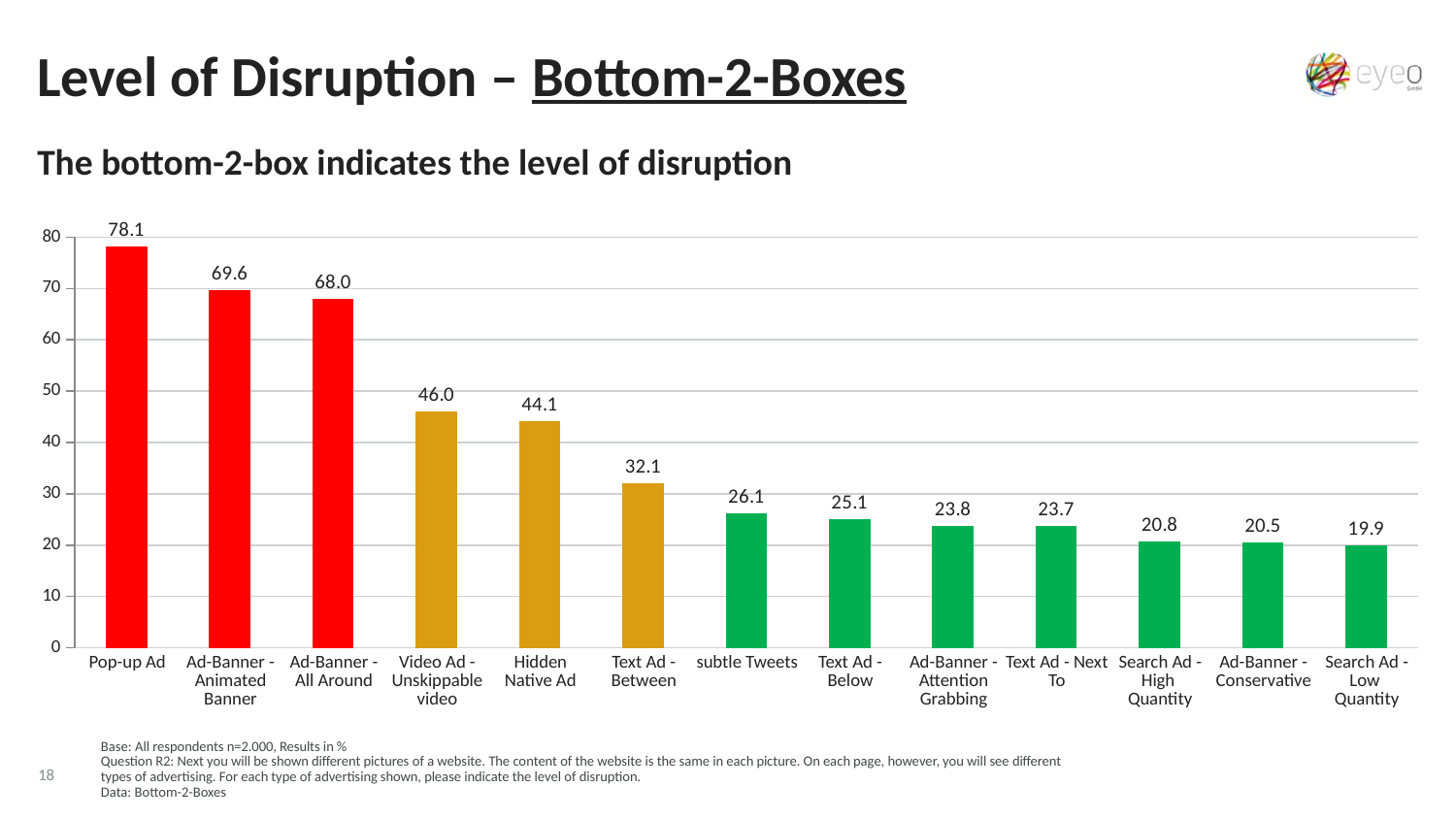
What is the difference between the values for Pop-up Ad and Ad-Banner - Animated Banner? 8.5 Which category has the highest value? Pop-up Ad What is the value for Search Ad - Low Quantity? 19.9 What is the value for Pop-up Ad? 78.1 Do the values rise or fall from left to right along the x axis? fall What kind of chart is shown on the slide? bar chart Which is larger, the value for Ad-Banner - All Around or the value for Video Ad - Unskippable video? Ad-Banner - All Around Which category has the lowest value? Search Ad - Low Quantity What is the value for Hidden Native Ad? 44.1 Is the value for subtle Tweets greater or less than 30? less What is the difference between the values for Video Ad - Unskippable video and Text Ad - Between? 13.9 How many categories are shown on the chart? 13